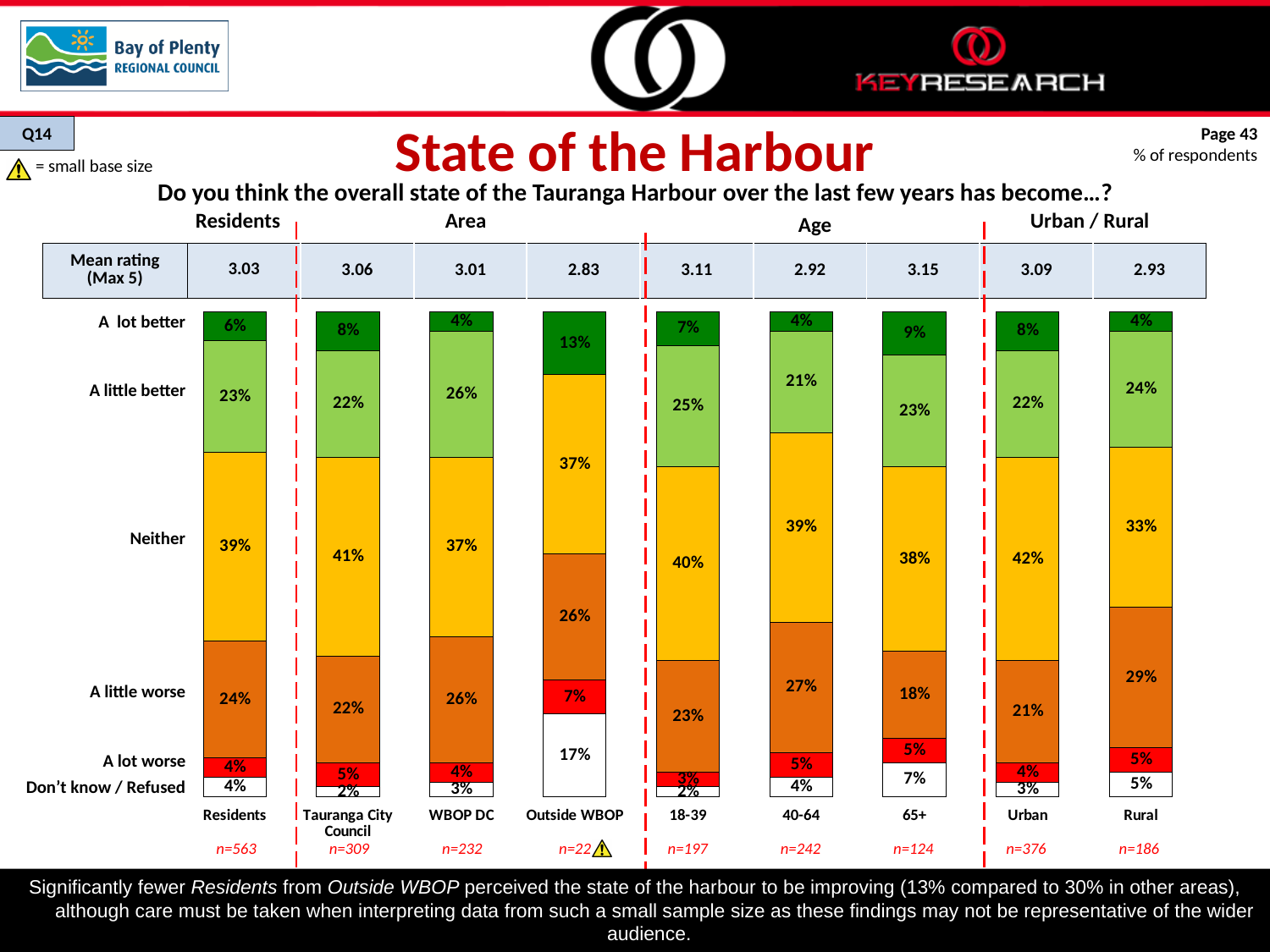
What is the sample size (n) for the Outside WBOP group? n=22 What is the mean rating (Max 5) for the 18-39 age group? 3.11 Which group has the highest 'Neither' percentage? Urban How many respondent groups (bars) are shown in the chart? 9 What percentage of Outside WBOP respondents answered 'A lot better'? 13% Which is larger: the 'A little better' percentage for WBOP DC or for Tauranga City Council? WBOP DC What percentage of 65+ respondents answered 'Don't know / Refused'? 7% How many response categories are stacked in each bar? 6 What is the difference between the 'A little worse' percentages for Rural and Urban respondents? 8% Which group has the lowest mean rating? Outside WBOP What percentage of Residents said the state of the harbour has become 'Neither' better nor worse? 39% What type of chart is used on this slide? Stacked bar chart